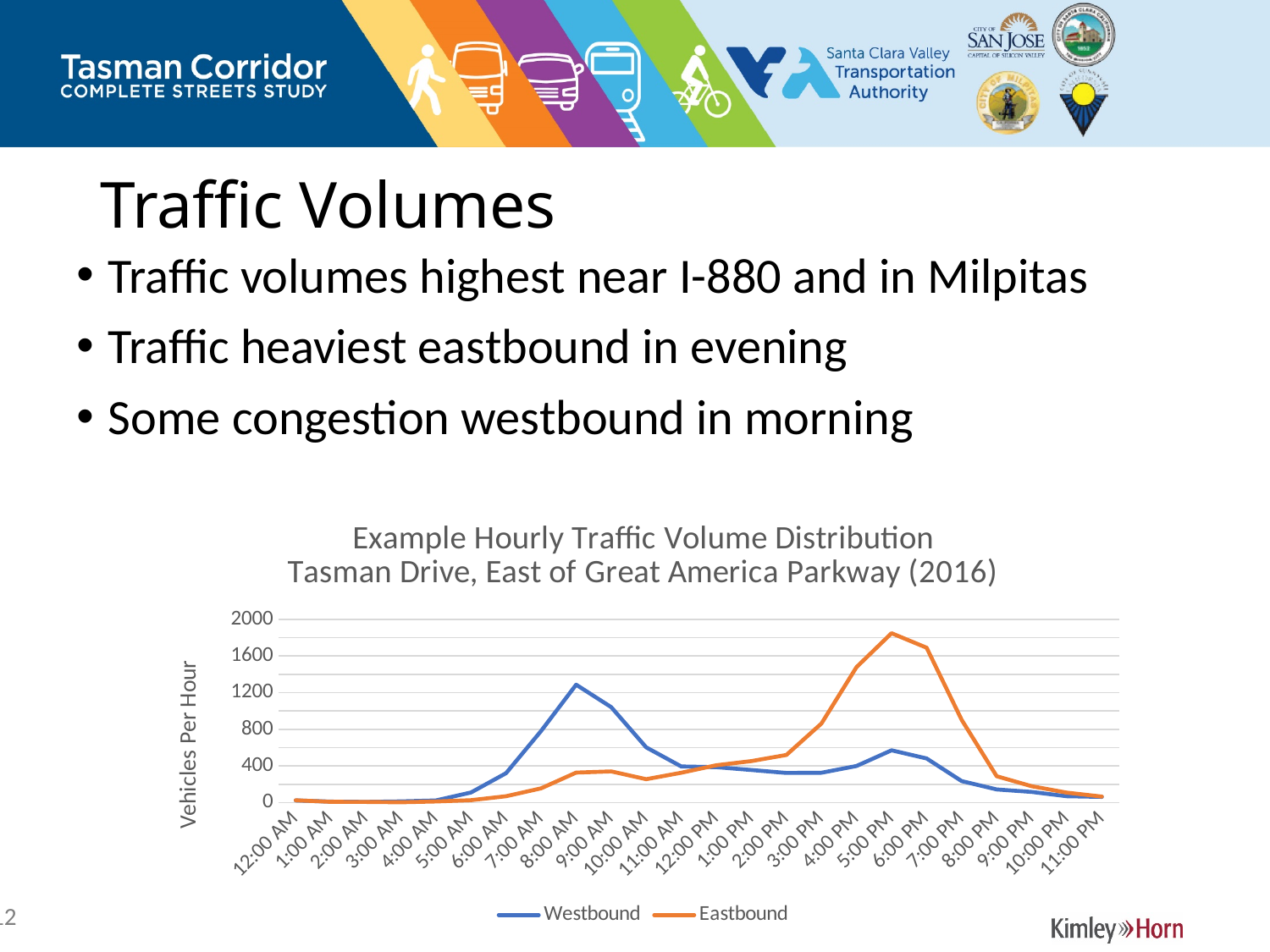
Is the Westbound value at 8:00 AM greater or less than 800? greater Which series reaches a higher peak value, Westbound or Eastbound? Eastbound What kind of chart is shown on the slide? line chart Does the Eastbound series rise or fall between 12:00 PM and 5:00 PM? rise What is the label on the vertical axis of the chart? Vehicles Per Hour At 8:00 AM, which series has the larger value, Westbound or Eastbound? Westbound Is the Eastbound value at 5:00 PM greater or less than 1600? greater How many hourly time points are plotted along the x axis? 24 At which hour does the Eastbound series reach its highest value? 5:00 PM At which hour does the Westbound series reach its highest value? 8:00 AM Is the Eastbound value at 8:00 AM greater or less than 400? less How many series does the chart legend list? 2